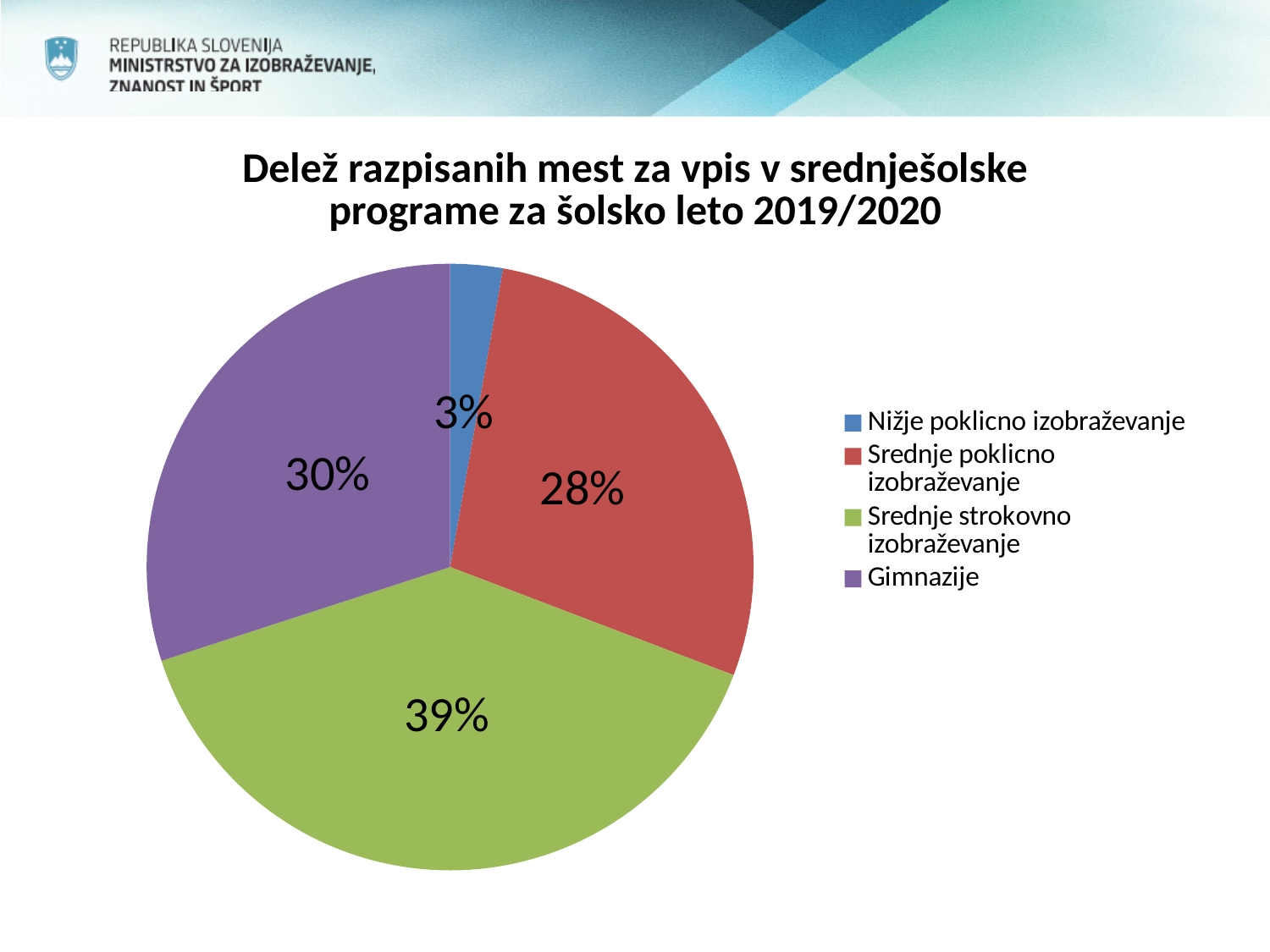
Which category has the smallest slice of the pie? Nižje poklicno izobraževanje What is the difference between the shares of Srednje strokovno izobraževanje and Gimnazije? 9% What colour is the slice for Gimnazije? purple What share of the pie does Srednje strokovno izobraževanje have? 39% What kind of chart is shown on the slide? pie chart How many categories does the pie chart show? 4 What share of the pie does Srednje poklicno izobraževanje have? 28% What is the title of the chart? Delež razpisanih mest za vpis v srednješolske programe za šolsko leto 2019/2020 What share of the pie does Nižje poklicno izobraževanje have? 3% Which category has the largest slice of the pie? Srednje strokovno izobraževanje Which is larger, the share for Gimnazije or the share for Srednje poklicno izobraževanje? Gimnazije